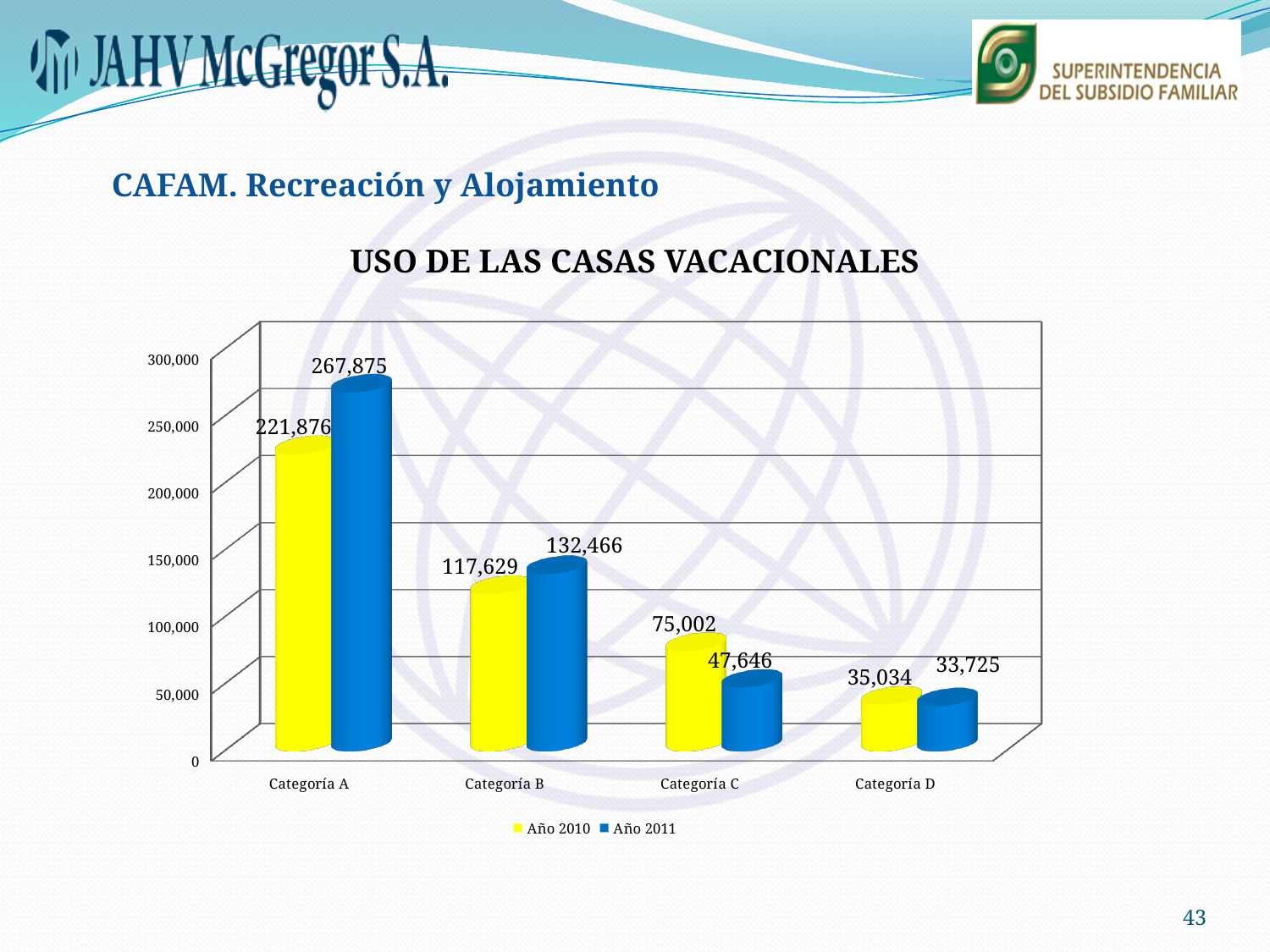
What is the value for Categoría A in Año 2011? 267,875 What is the value for Categoría C in Año 2010? 75,002 Which category has the highest value for Año 2010? Categoría A Which is larger for Categoría C: the Año 2010 value or the Año 2011 value? Año 2010 Is the value for Categoría B in Año 2010 greater or less than 100,000? greater What kind of chart is shown? bar chart How many series does the legend list? 2 What is the value for Categoría D in Año 2011? 33,725 Which category has the lowest value for Año 2011? Categoría D How many categories are shown on the x axis? 4 What is the difference between the Año 2011 and Año 2010 values for Categoría B? 14,837 What is the title of the chart? USO DE LAS CASAS VACACIONALES